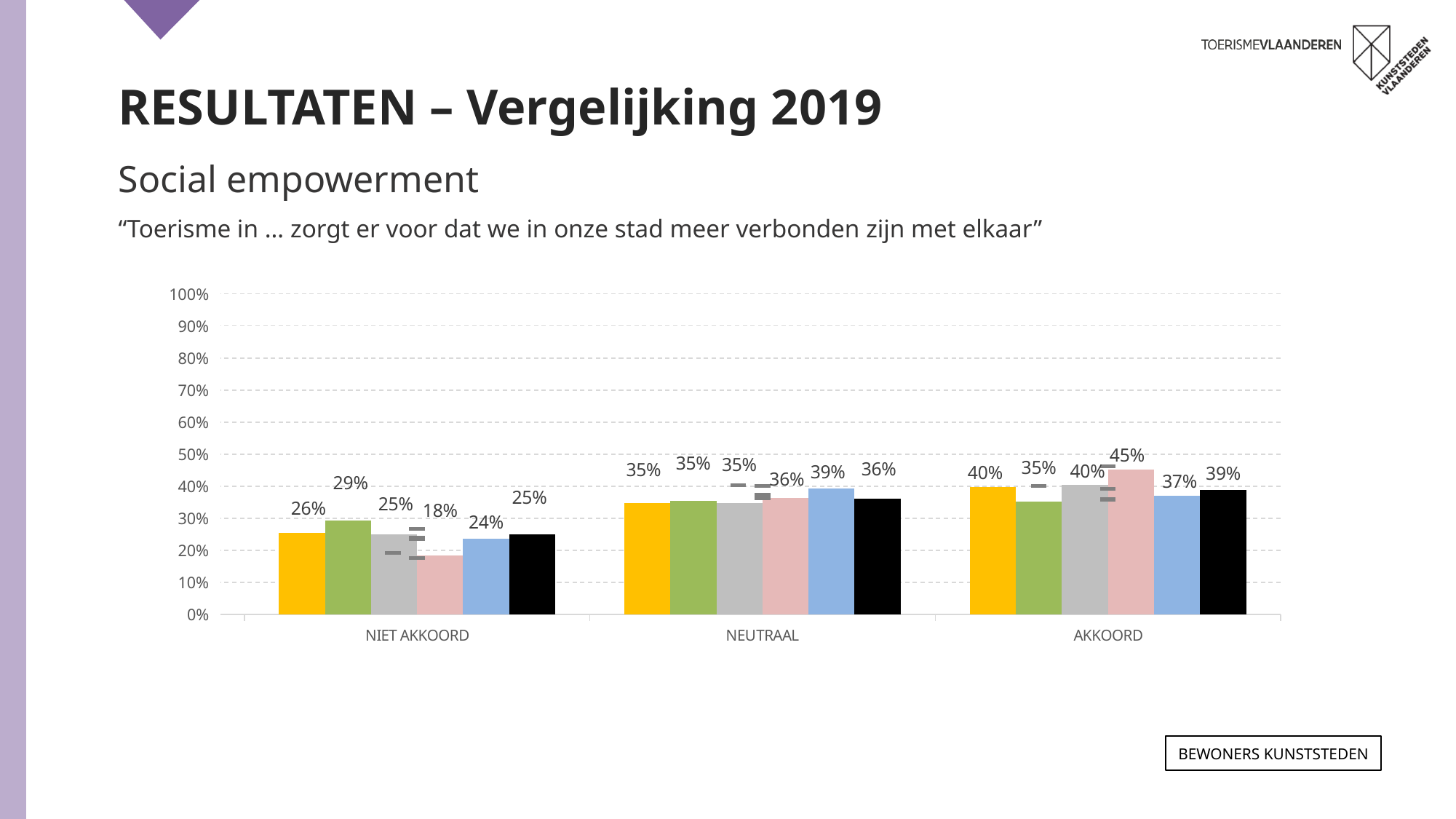
How many categories are shown on the x axis of the chart? 3 What is the value of the green bar in the NIET AKKOORD category? 29% How many bars are plotted for each category in the chart? 6 What is the value of the blue bar in the NEUTRAAL category? 39% What is the value of the pink bar in the AKKOORD category? 45% What is the difference between the pink bar in AKKOORD (45%) and the pink bar in NIET AKKOORD (18%)? 27% Which bar in the AKKOORD category has the highest value? the pink bar (45%) What type of chart is shown on the slide? bar chart Which bar in the NIET AKKOORD category has the lowest value? the pink bar (18%) What is the statement quoted above the chart? “Toerisme in … zorgt er voor dat we in onze stad meer verbonden zijn met elkaar” Is the yellow bar in the AKKOORD category larger or smaller than the yellow bar in the NIET AKKOORD category? larger What is the value of the pink bar in the NIET AKKOORD category? 18%